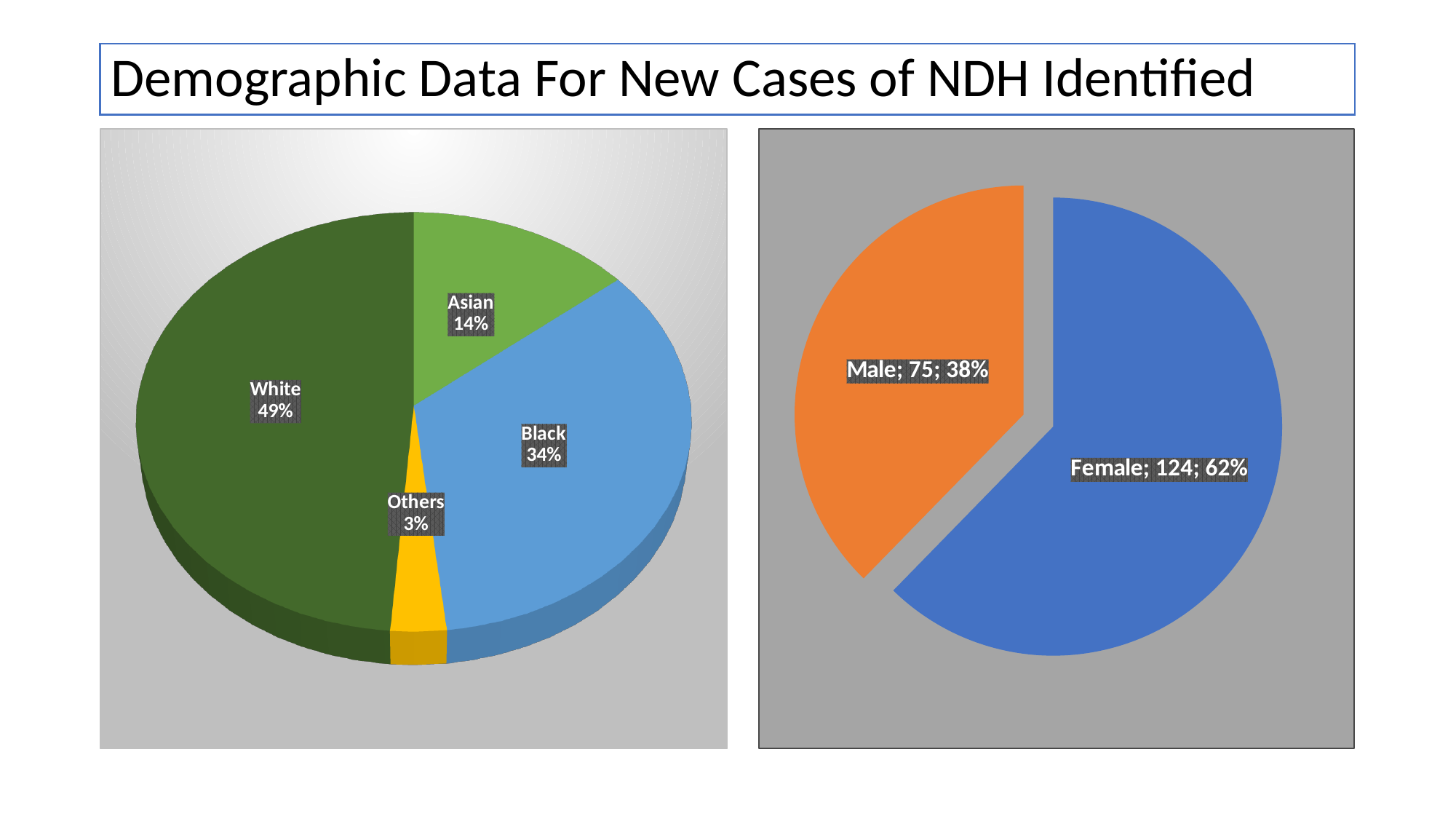
In the right pie chart, which is larger, Male or Female? Female In the left pie chart, how many categories are shown? 4 In the left pie chart, which category has the largest share? White In the right pie chart, what is the total number of cases across Male and Female? 199 In the left pie chart, what is the difference in percentage points between White and Black? 15 In the right pie chart, what percentage of cases are Male? 38% In the left pie chart, which category has the smallest share? Others What type of chart is shown on the right side of the slide? Pie chart In the left pie chart, what percentage is shown for Black? 34% In the left pie chart, what percentage is shown for White? 49% In the right pie chart, how many cases are Female? 124 In the left pie chart, what percentage is shown for Asian? 14%